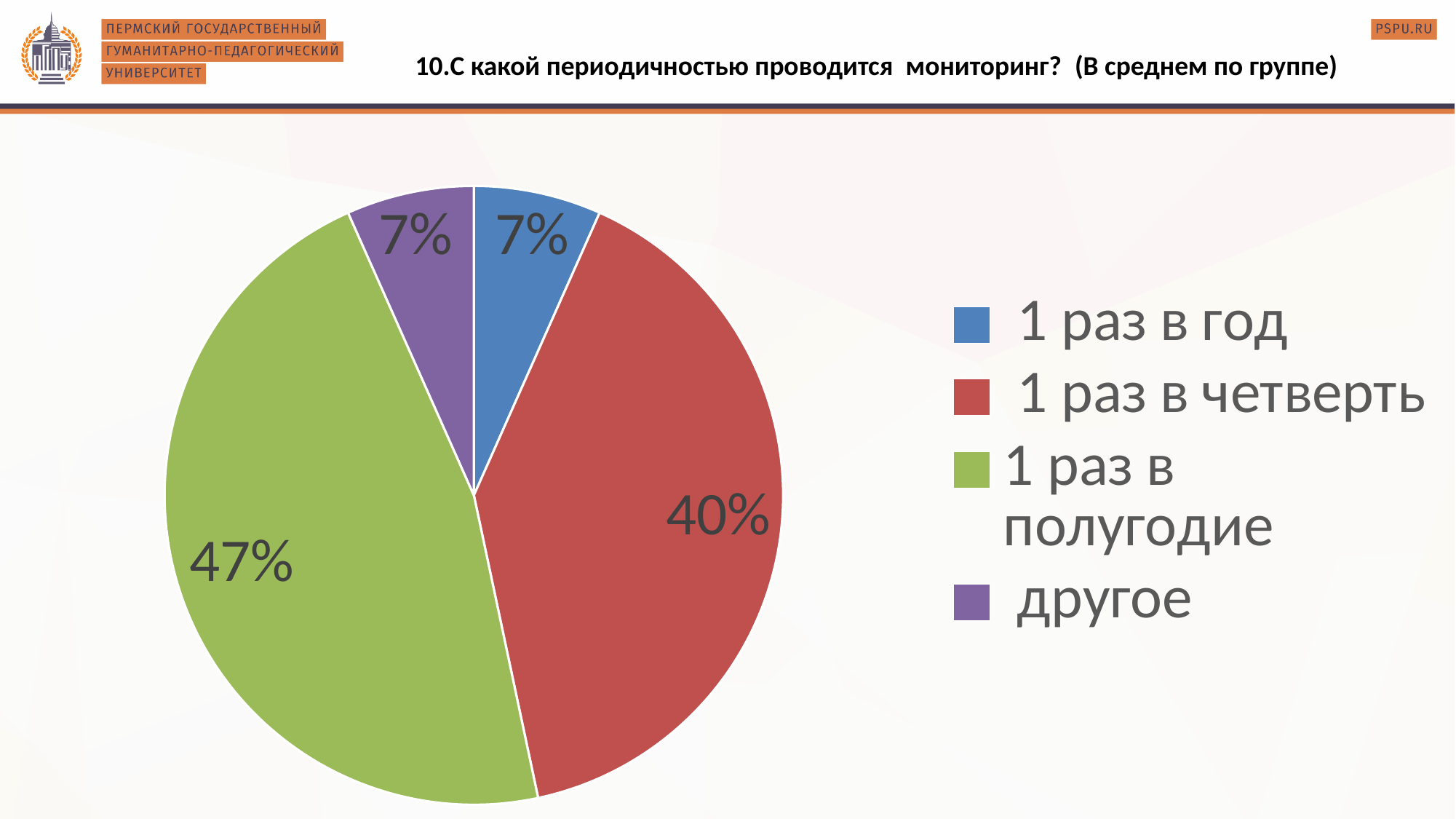
What is the title of the chart on the slide? 10.С какой периодичностью проводится мониторинг? (В среднем по группе) What kind of chart is shown on the slide? pie chart What share of the pie does "1 раз в четверть" have? 40% What share of the pie does "1 раз в год" have? 7% What is the combined share of "1 раз в год" and "другое"? 14% What share of the pie does "другое" have? 7% What colour is the slice for "1 раз в четверть"? red How many categories does the legend list? 4 Which category has the largest slice of the pie? 1 раз в полугодие Which is larger: the share for "1 раз в четверть" or the share for "1 раз в год"? 1 раз в четверть What is the difference between the shares of "1 раз в полугодие" and "1 раз в четверть"? 7% What share of the pie does "1 раз в полугодие" have? 47%